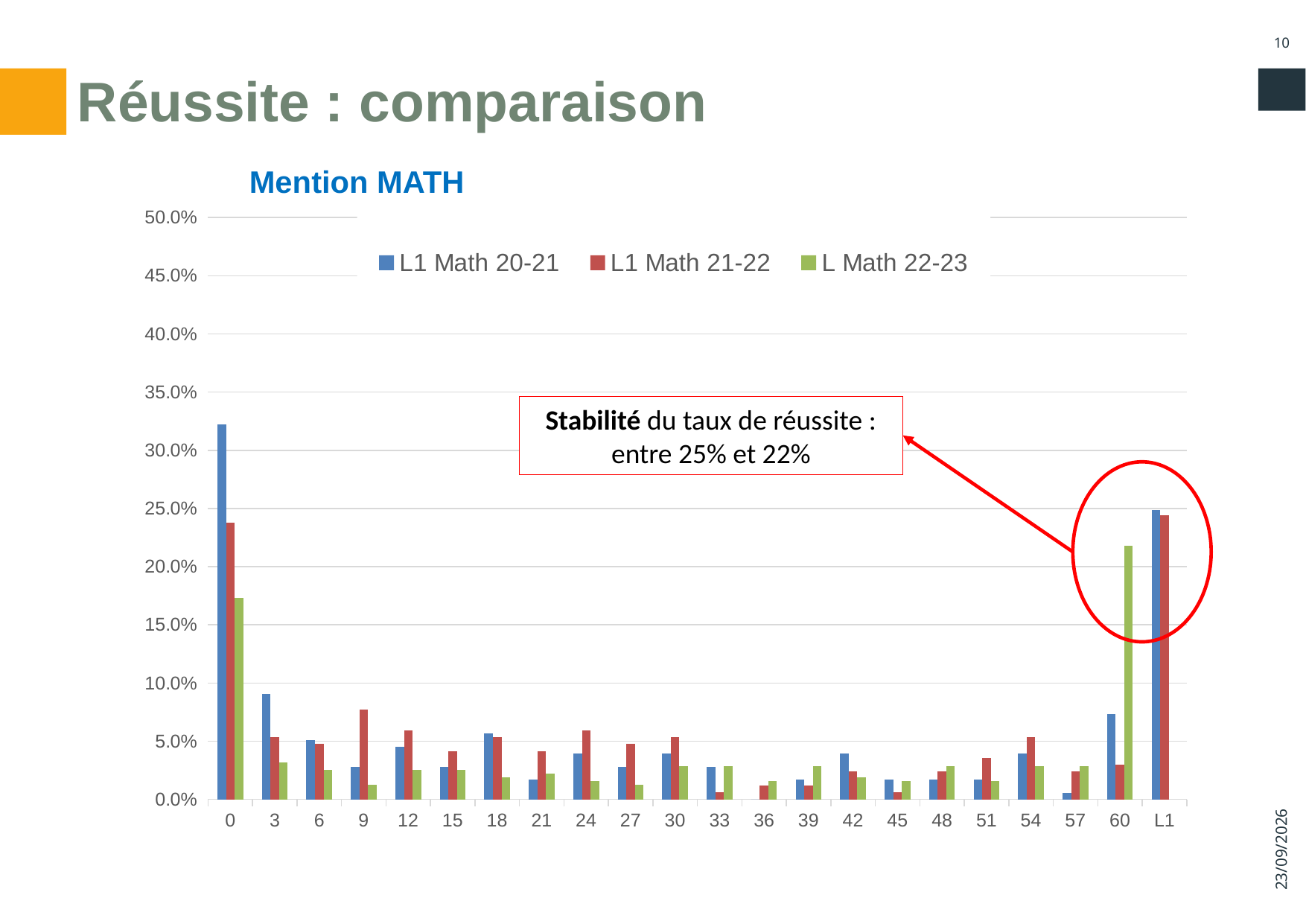
Is the value for category 0 in the L1 Math 21-22 series greater or less than 25.0%? less What is the title of the chart? Mention MATH Is the value for category 3 in the L1 Math 20-21 series greater or less than 10.0%? less What kind of chart is shown on the slide? bar chart How many categories are shown on the x axis of the Mention MATH chart? 22 Which series is shown in green in the Mention MATH chart? L Math 22-23 Is the value for category 60 in the L Math 22-23 series greater or less than 20.0%? greater At category 60, which series has the larger value: L1 Math 20-21 or L Math 22-23? L Math 22-23 How many series does the legend of the Mention MATH chart list? 3 For the L Math 22-23 series, which category has the highest value? 60 For the L1 Math 20-21 series, which category has the highest value? 0